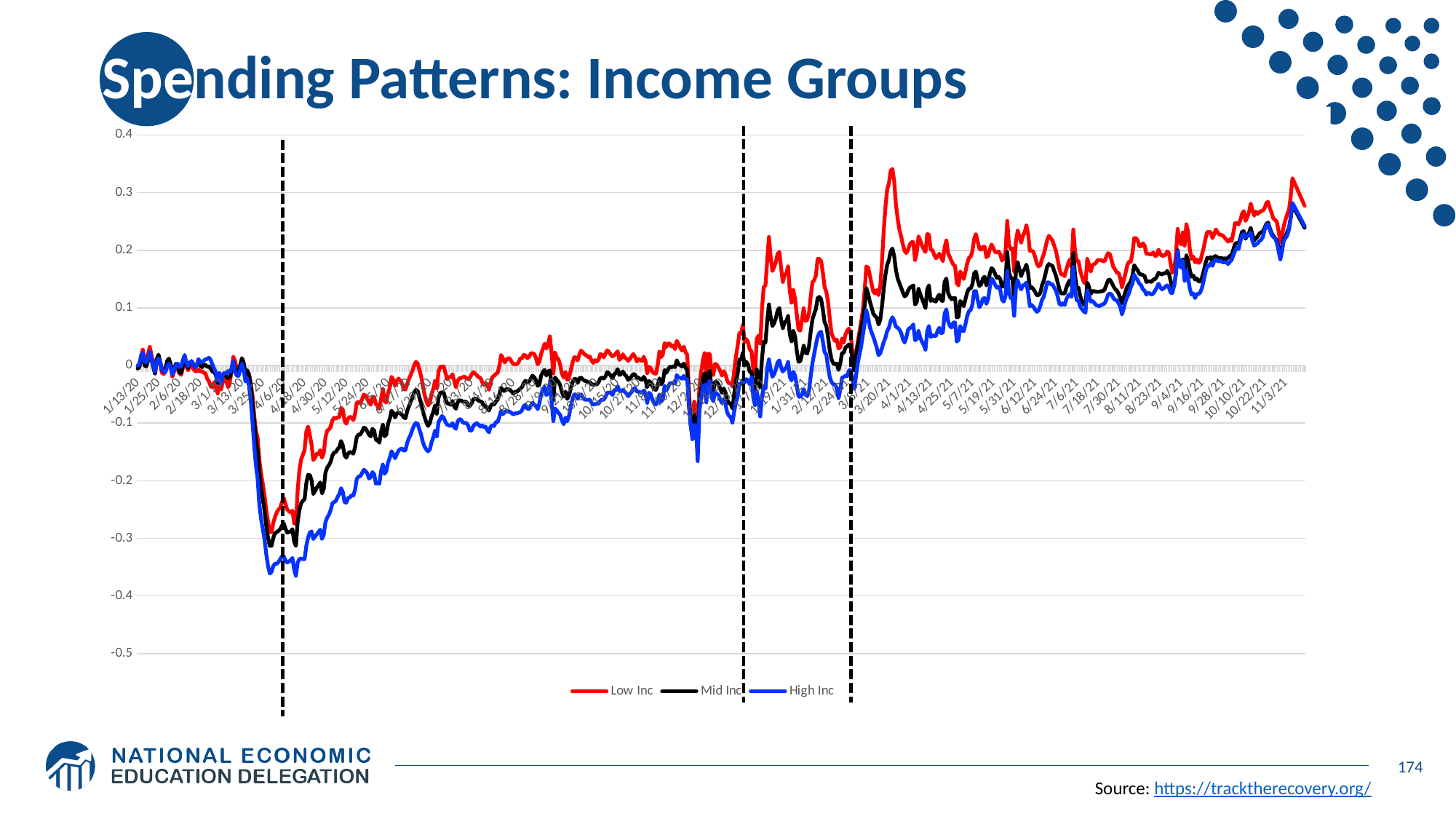
What is the title of the slide's chart? Spending Patterns: Income Groups Which series is highest at the right end of the chart (November 2021)? Low Inc From the trough in April 2020 to November 2021, do the series generally rise or fall? rise Is the peak value for Low Inc around early April 2021 greater or less than 0.3? greater What is the lowest value shown on the vertical axis? -0.5 What kind of chart is shown on the slide? line chart Is the value for High Inc at its lowest point in early April 2020 greater or less than -0.3? less Around 4/13/21, which series has the larger value, Low Inc or High Inc? Low Inc Is the value for High Inc around 4/13/21 greater or less than 0.1? less Which series reaches the lowest value during the trough in late March / early April 2020? High Inc Which series is drawn in blue? High Inc How many series does the legend list? 3